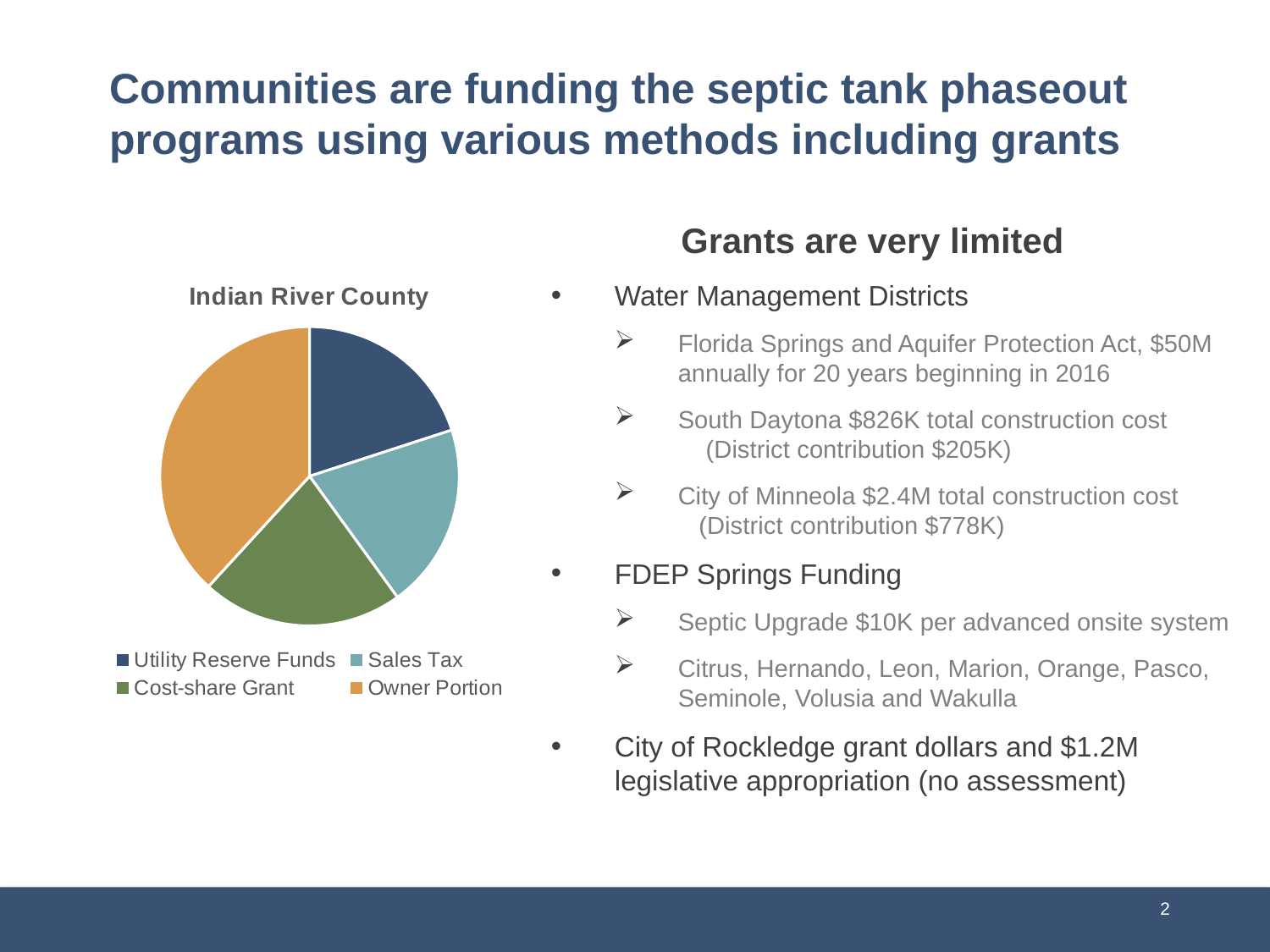
What is the title of the pie chart? Indian River County What kind of chart is shown on the slide? Pie chart In the Indian River County pie chart, which slice is larger: Owner Portion or Sales Tax? Owner Portion How many entries does the legend of the Indian River County pie chart list? 4 How many slices does the Indian River County pie chart have? 4 In the Indian River County pie chart, which slice is larger: Cost-share Grant or Owner Portion? Owner Portion Which colour represents Owner Portion in the Indian River County pie chart? Orange In the Indian River County pie chart, which slice is larger: Owner Portion or Utility Reserve Funds? Owner Portion Which category has the largest slice in the Indian River County pie chart? Owner Portion